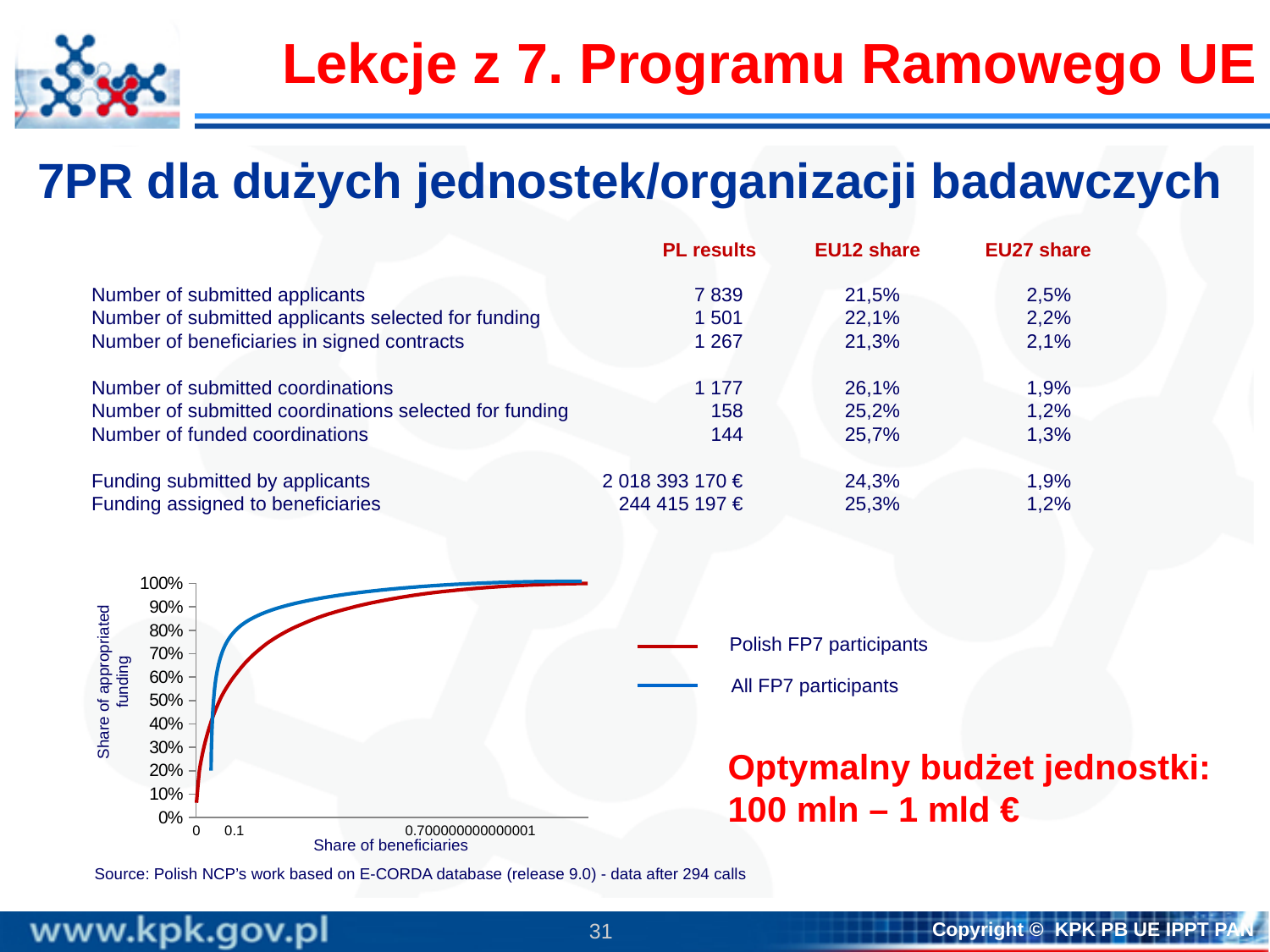
How many series does the legend of the line chart list? 2 How many tick labels are shown on the y axis of the line chart? 11 Do the curves in the line chart rise or fall as the share of beneficiaries increases? rise At a share of beneficiaries of 0.1, which series is higher in the line chart: Polish FP7 participants or All FP7 participants? All FP7 participants What kind of chart is shown at the bottom left of the slide? line chart At a share of beneficiaries of 0.1, is the value for All FP7 participants greater or less than 70%? greater At a share of beneficiaries of 0.1, is the value for Polish FP7 participants greater or less than 50%? greater What is the highest value shown on the y axis of the line chart? 100% What is the title of the y axis of the line chart? Share of appropriated funding Which series in the line chart is drawn in red? Polish FP7 participants